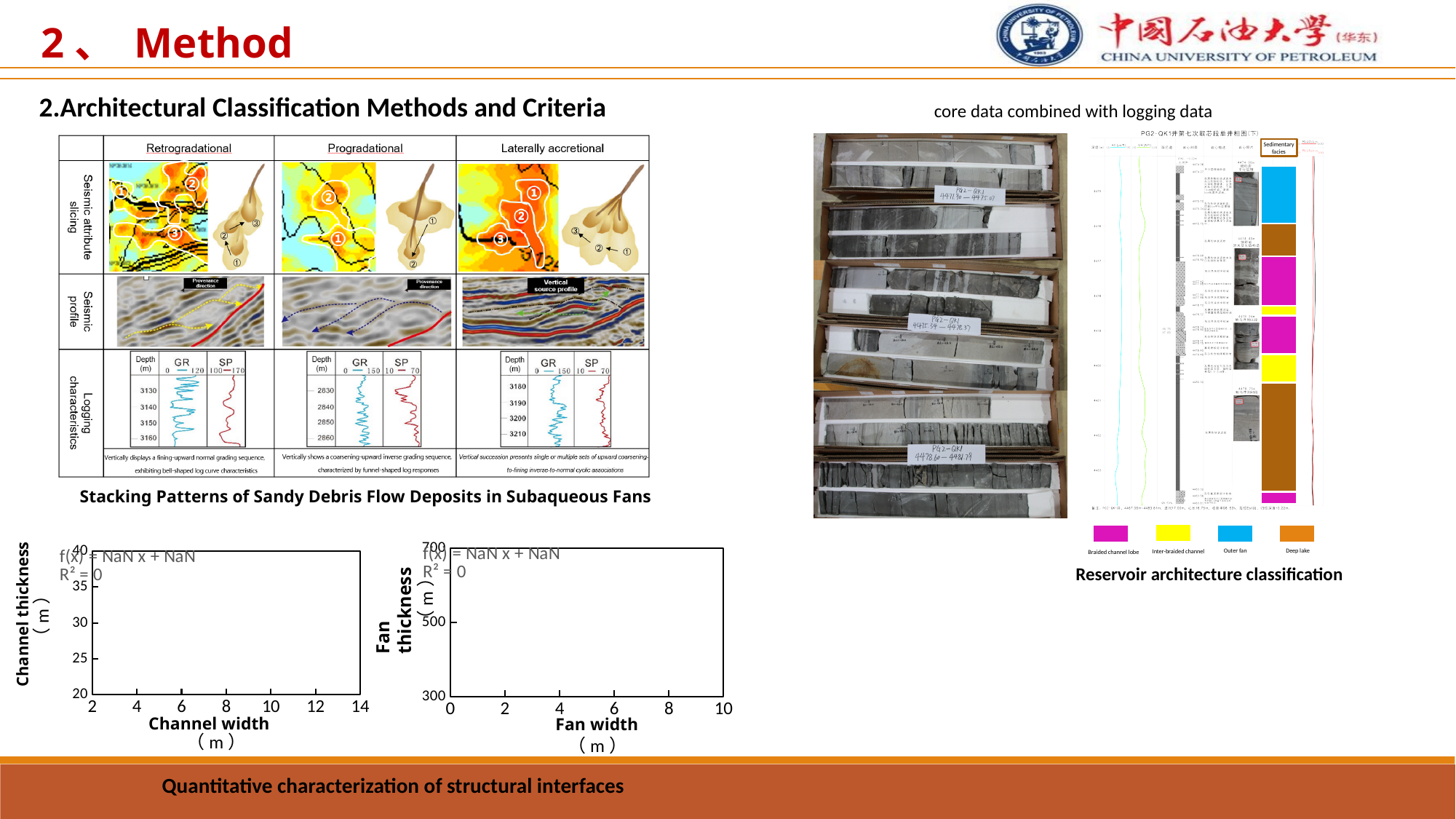
What kind of chart is the right chart with x axis 'Fan width (m)'? scatter chart On the left chart (Channel width vs Channel thickness), how many data points are plotted? 0 What is the x-axis title of the right chart at the bottom of the slide? Fan width (m) What R² value is printed on the right chart (Fan width vs Fan thickness)? 0 On the right chart (Fan width vs Fan thickness), how many data points are plotted? 0 What is the y-axis title of the left chart at the bottom of the slide? Channel thickness (m) What R² value is printed on the left chart (Channel width vs Channel thickness)? 0 What kind of chart is the left chart with x axis 'Channel width (m)'? scatter chart